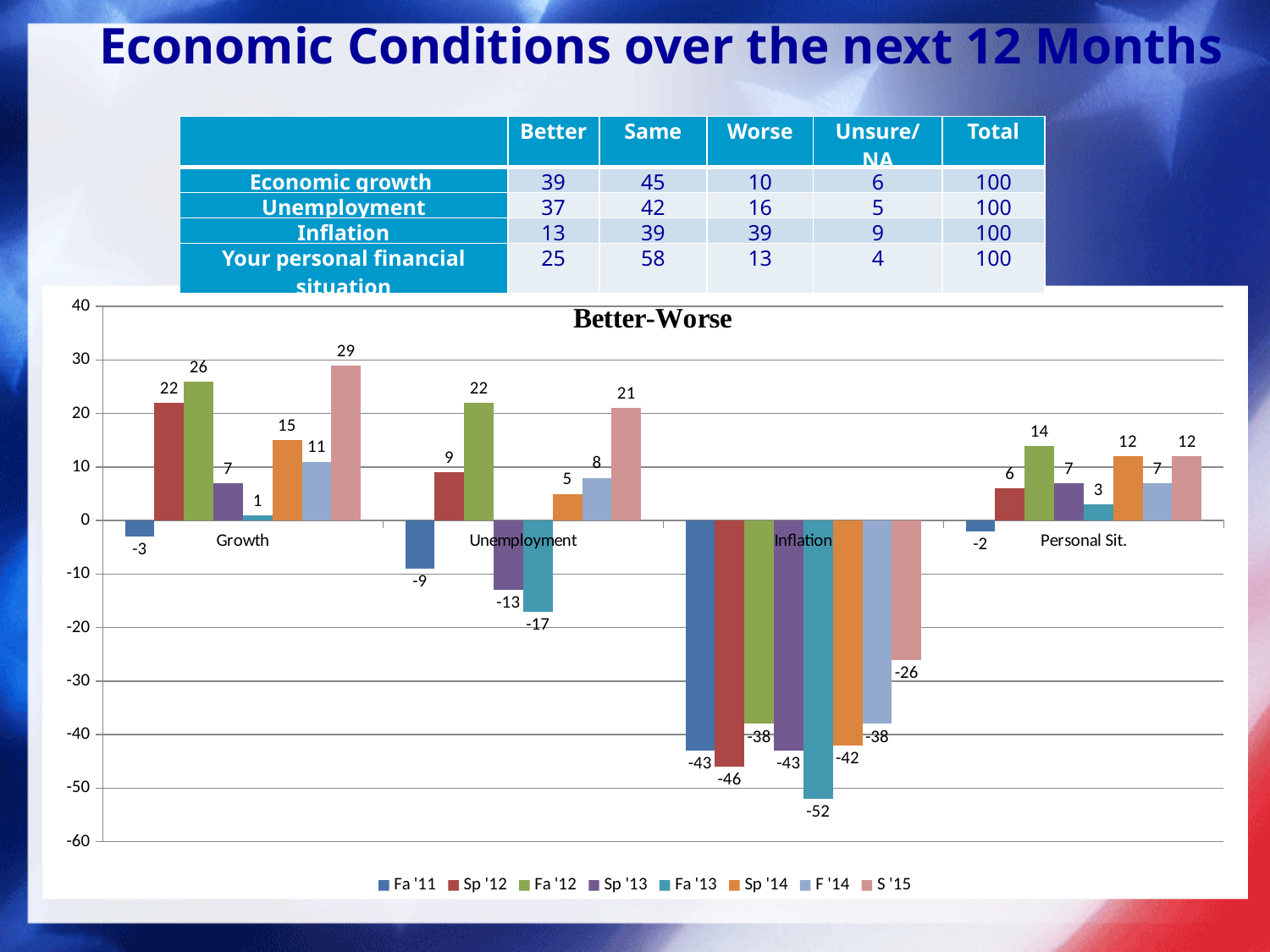
How many series does the legend list? 8 What is the difference between the S '15 value for Growth and the S '15 value for Unemployment? 8 How many categories are shown on the x axis? 4 What is the value for Inflation in the Fa '13 series? -52 Which series has the highest value for Growth? S '15 Which is larger for Inflation: the Sp '12 value or the S '15 value? S '15 What kind of chart is this? Bar chart Which category has the lowest value in the Fa '13 series? Inflation What is the value for Growth in the S '15 series? 29 What is the value for Unemployment in the Fa '12 series? 22 What is the value for Personal Sit. in the Fa '11 series? -2 What is the title of the chart? Better-Worse